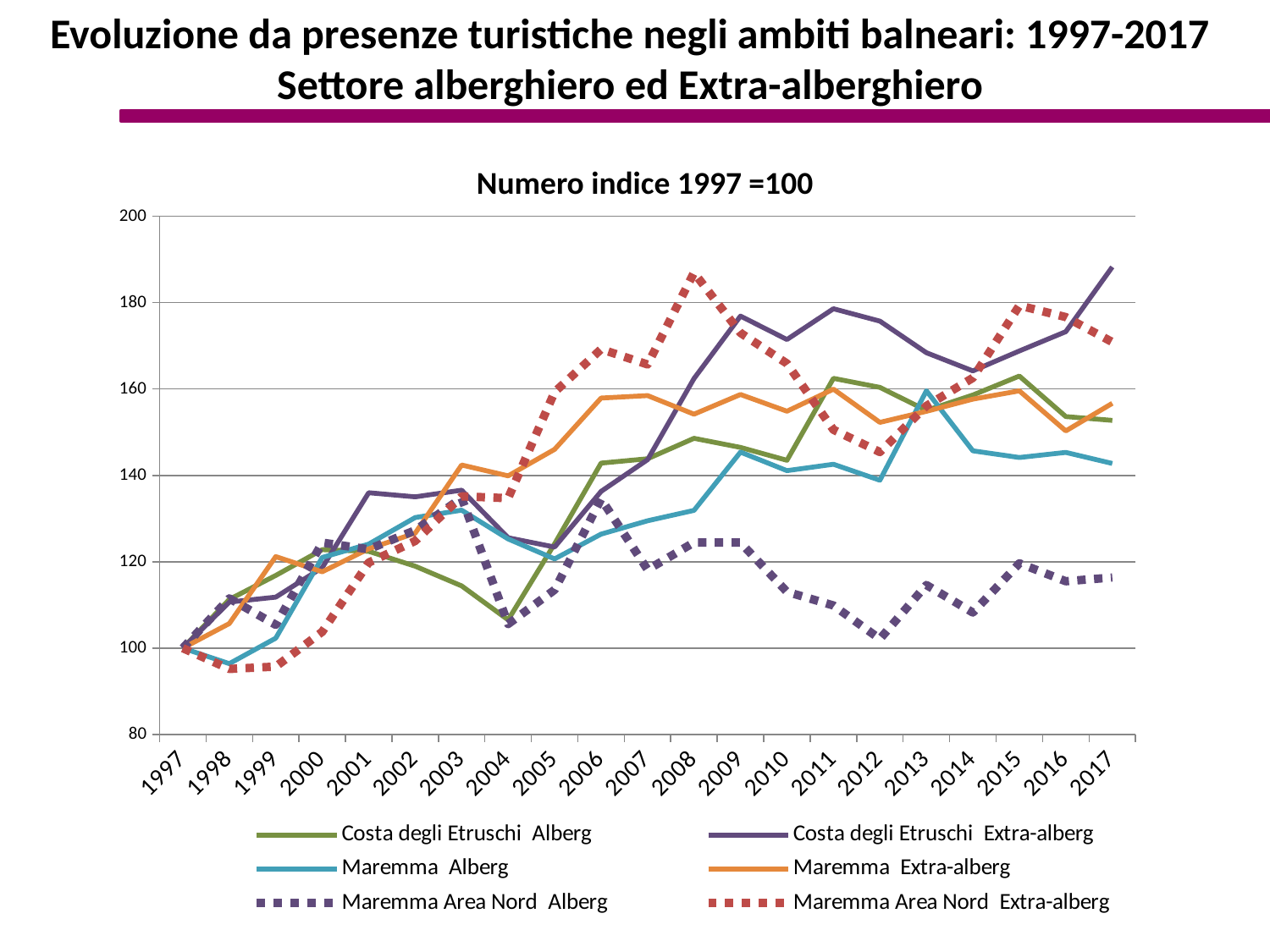
What is the title of the chart? Numero indice 1997 =100 Does the Costa degli Etruschi Extra-alberg series rise or fall overall from 1997 to 2017? Rise Is the value for Maremma Area Nord Extra-alberg in 2008 greater or less than 180? greater Which series has the highest value in 2017? Costa degli Etruschi Extra-alberg Which series has the lowest value in 2017? Maremma Area Nord Alberg Is the value for Maremma Area Nord Alberg in 2012 greater or less than 120? less What is the value of every series in 1997? 100 How many series does the legend list? 6 What kind of chart is shown on the slide? Line chart Is the value for Costa degli Etruschi Extra-alberg in 2017 greater or less than 180? greater In 2008, which is larger: Maremma Area Nord Extra-alberg or Maremma Alberg? Maremma Area Nord Extra-alberg How many years are plotted along the x axis? 21